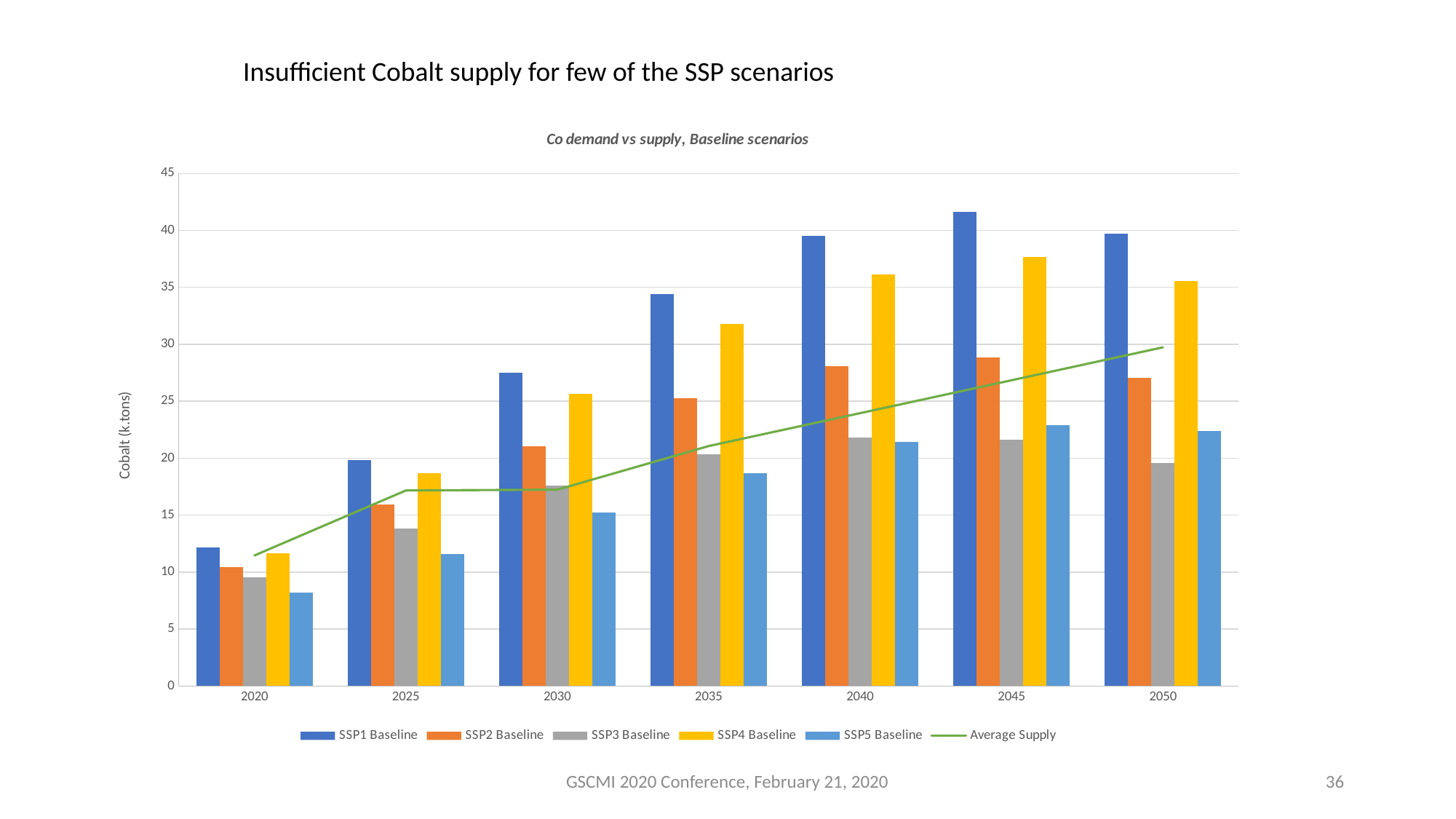
Is the SSP1 Baseline value for 2040 greater or less than 35? greater Does the Average Supply line rise or fall from 2020 to 2050? rise How many series does the legend list? 6 Is the SSP5 Baseline value for 2050 greater or less than 20? greater In 2030, which is larger: SSP2 Baseline or SSP4 Baseline? SSP4 Baseline What kind of chart is shown on the slide? bar chart (with a line series) Is the SSP3 Baseline value for 2020 greater or less than 10? less How many years are shown along the x axis? 7 What is the title of the chart? Co demand vs supply, Baseline scenarios In which year is the SSP1 Baseline bar the highest? 2045 What is the label on the y axis? Cobalt (k.tons) In which year is the SSP5 Baseline bar the lowest? 2020